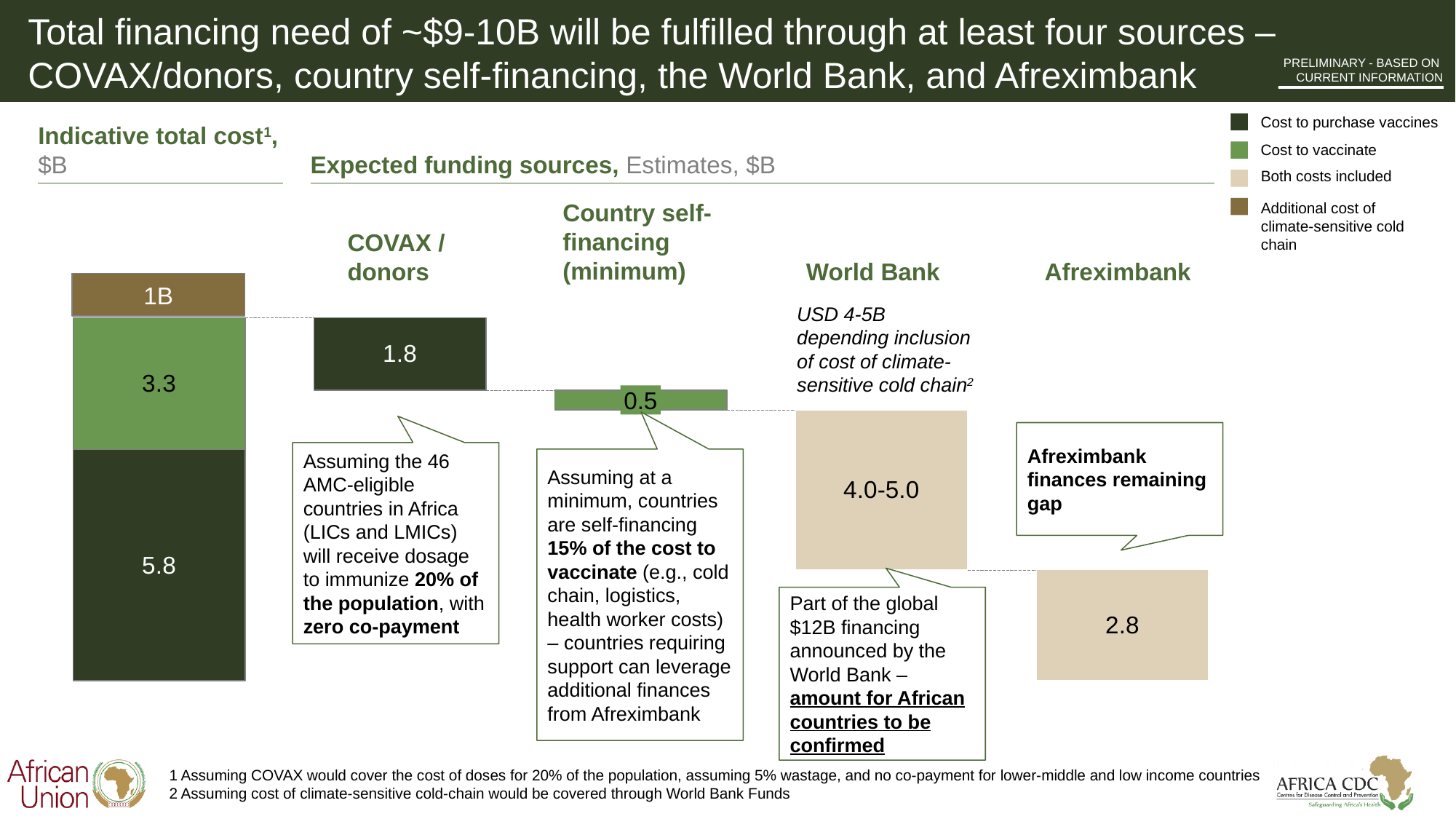
What is the expected funding value shown for the World Bank? 4.0-5.0 What is the expected funding value for Country self-financing (minimum)? 0.5 In the Indicative total cost bar, what is the value of the Cost to purchase vaccines segment? 5.8 In the Indicative total cost bar, what is the value of the Additional cost of climate-sensitive cold chain segment? 1B Which is larger, the COVAX / donors funding or the Afreximbank funding? Afreximbank What is the difference between the Afreximbank funding and the COVAX / donors funding? 1.0 How many expected funding sources are shown in the chart? 4 In the Indicative total cost bar, what is the value of the Cost to vaccinate segment? 3.3 What is the expected funding value for Afreximbank? 2.8 How many entries does the legend list? 4 What is the expected funding value for COVAX / donors? 1.8 Which expected funding source has the smallest value? Country self-financing (minimum)